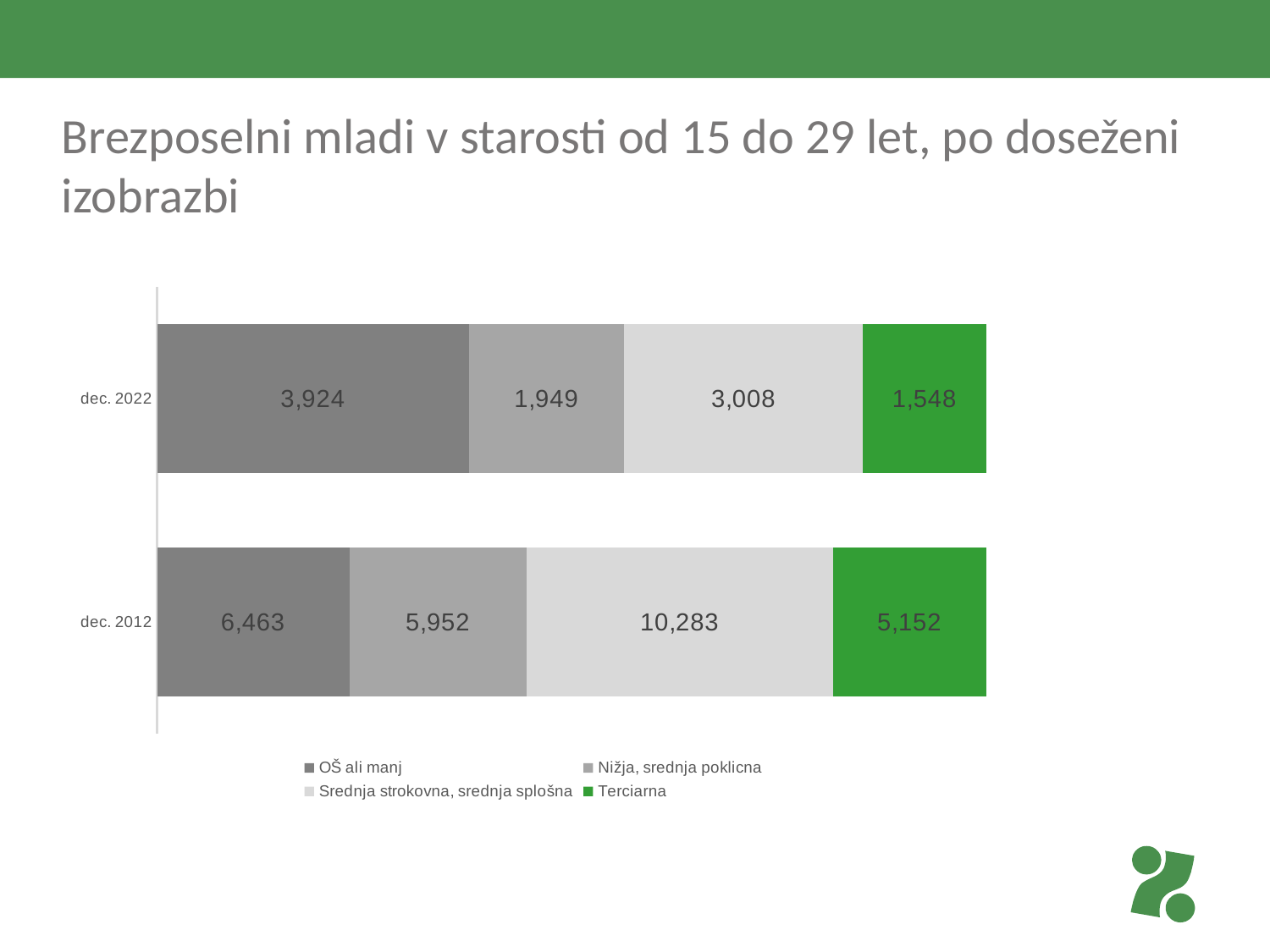
How many series does the legend list? 4 Which education group has the highest value in dec. 2012? Srednja strokovna, srednja splošna How many time periods (bars) are shown in the chart? 2 What is the value for "OŠ ali manj" in dec. 2022? 3,924 What is the difference between the "OŠ ali manj" values in dec. 2012 and dec. 2022? 2,539 What is the value for "Terciarna" in dec. 2022? 1,548 Which is larger: "Terciarna" in dec. 2012 or "Terciarna" in dec. 2022? dec. 2012 What kind of chart is shown on the slide? Stacked bar chart What is the total of the dec. 2022 bar? 10,429 What is the value for "Srednja strokovna, srednja splošna" in dec. 2012? 10,283 What is the value for "Nižja, srednja poklicna" in dec. 2012? 5,952 Which education group has the lowest value in dec. 2022? Terciarna